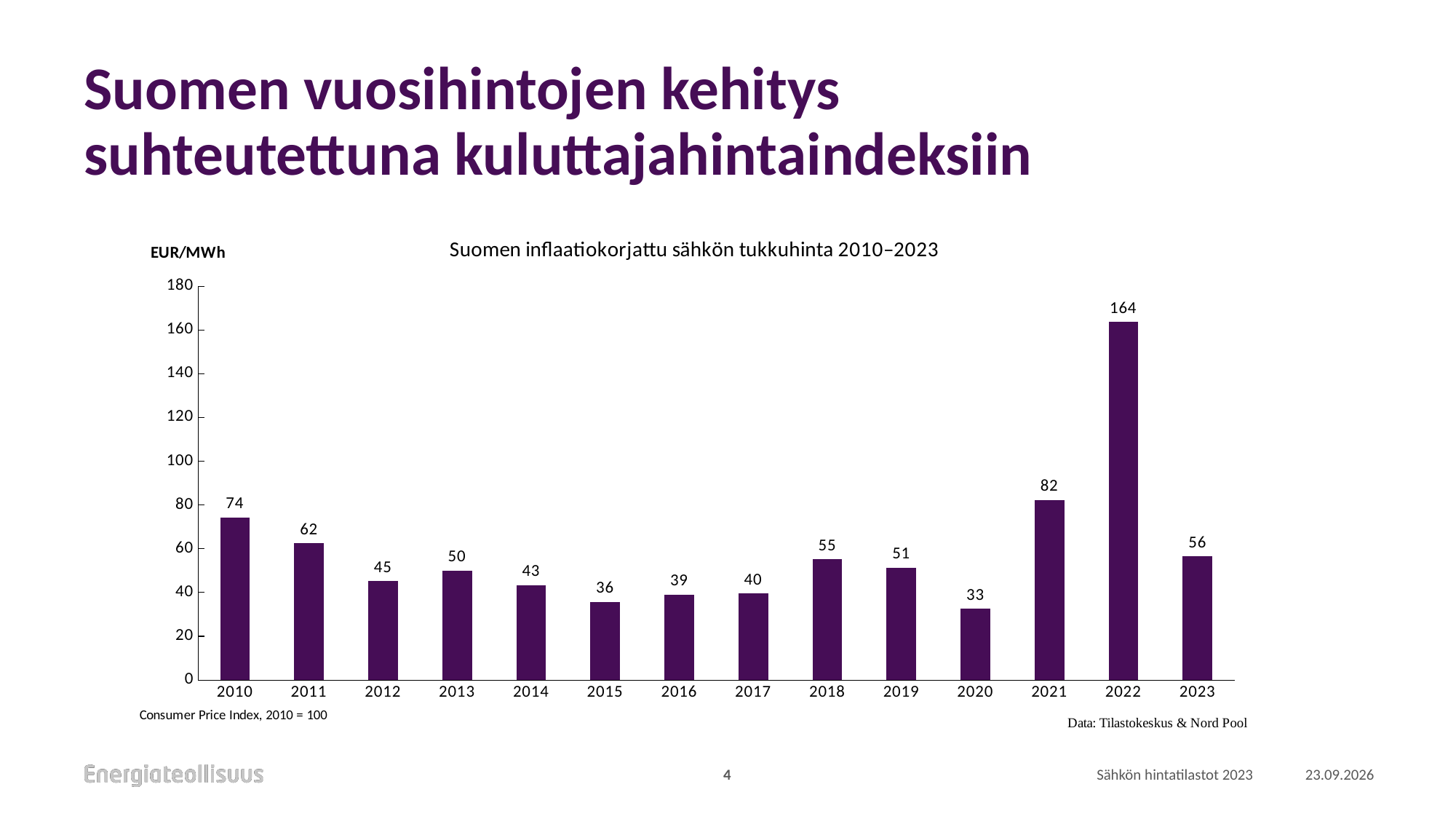
Do the values rise or fall from 2010 to 2015? fall What unit is shown on the y axis label? EUR/MWh What is the value for 2020? 33 How many years are shown on the x axis? 14 What kind of chart is shown on the slide? bar chart Which year has the highest value? 2022 Which is larger, the value for 2018 or the value for 2019? 2018 Is the value for 2021 greater or less than 100? less What is the value for 2022? 164 What is the value for 2010? 74 What is the difference between the values for 2022 and 2021? 82 Which year has the lowest value? 2020